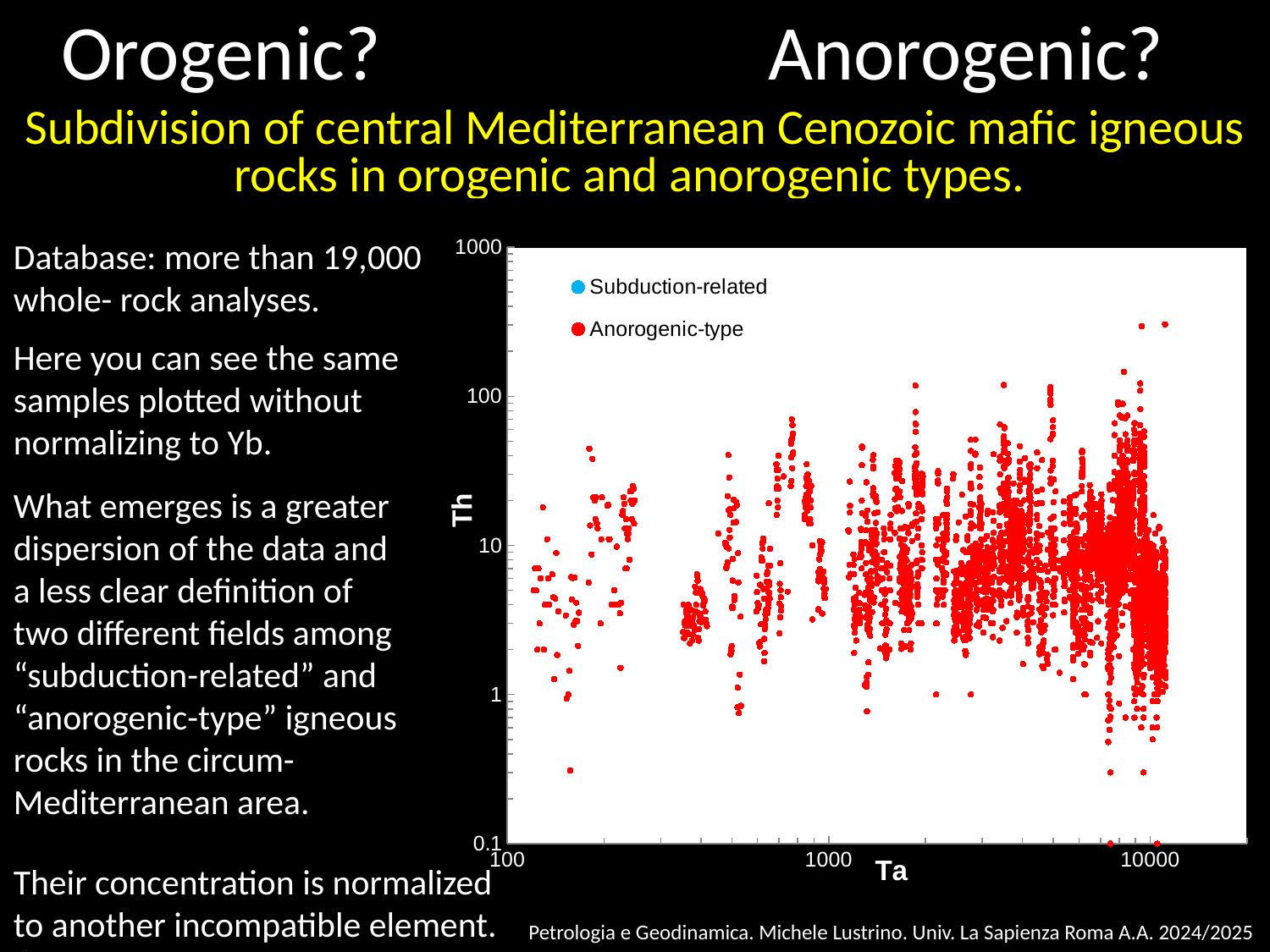
How many series does the legend of the Th versus Ta chart list? 2 Is the highest Th value plotted on the chart greater or less than 100? greater Is the lowest Ta value plotted on the chart greater or less than 1000? less What colour are the Anorogenic-type points in the chart? red Is the lowest Th value plotted on the chart greater or less than 1? less What kind of chart is shown on the slide? scatter chart Which element is plotted on the x axis of the chart? Ta